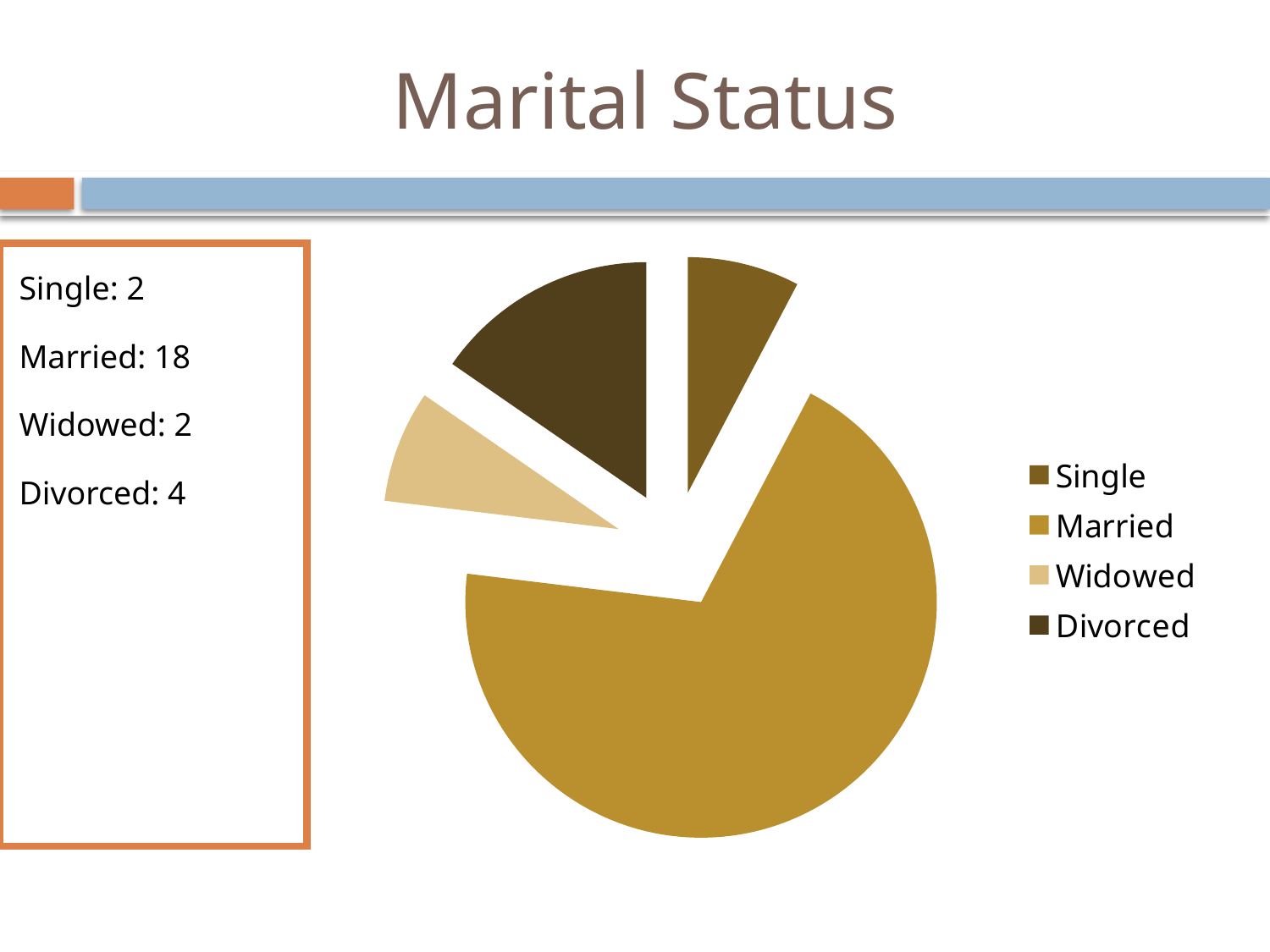
What is the value for Widowed? 2 What kind of chart is shown on the slide? pie chart What is the total of all four categories in the pie chart? 26 What is the value for Divorced? 4 What is the value for Married? 18 What is the title of the slide? Marital Status How many categories does the pie chart have? 4 What is the difference between the values for Married and Divorced? 14 How many entries does the legend list? 4 Which is larger, the value for Divorced or the value for Single? Divorced What is the value for Single? 2 Which category has the largest slice of the pie? Married